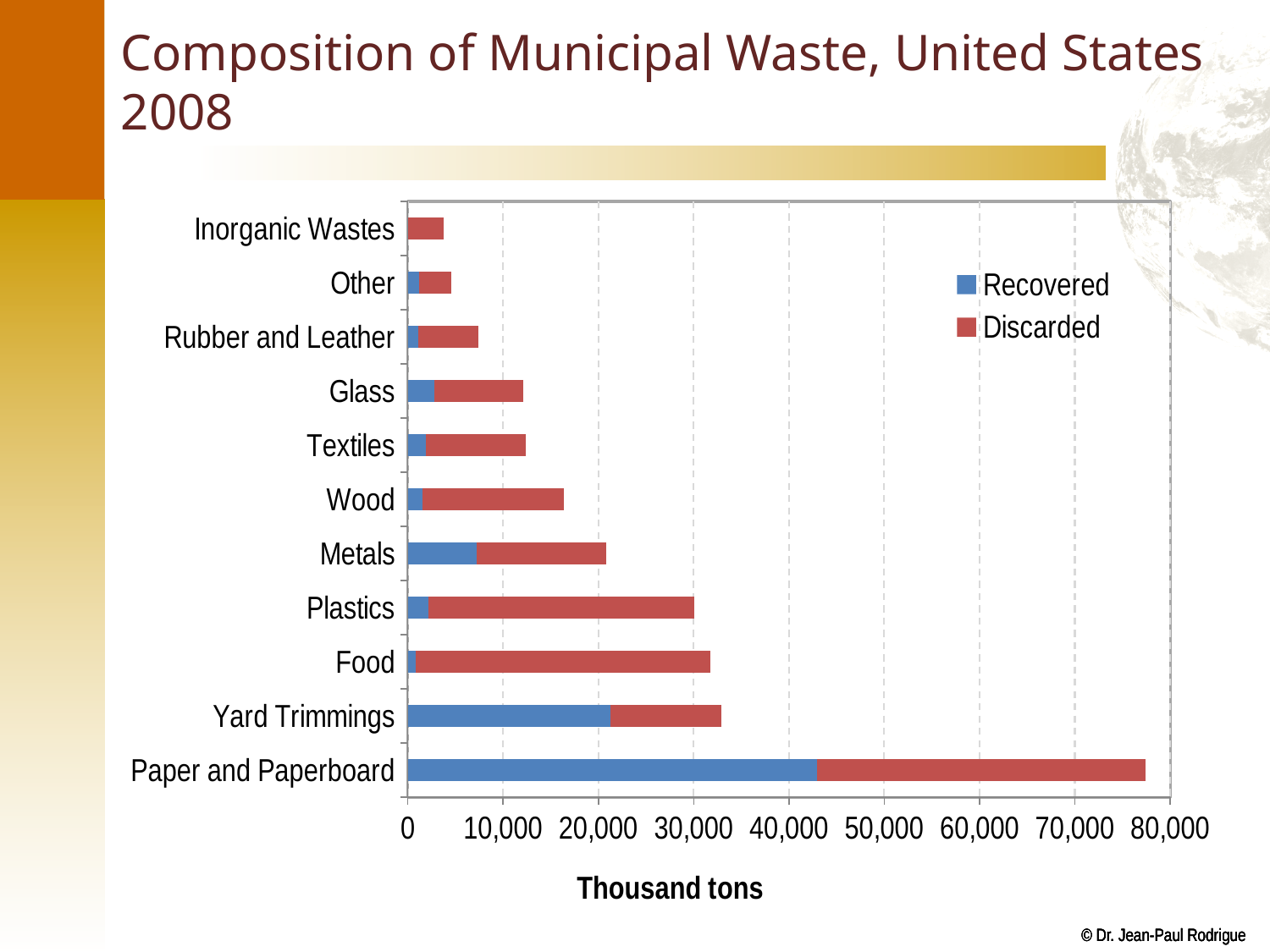
Is the total value for Yard Trimmings greater or less than 30,000? greater What kind of chart is shown on the slide? Stacked bar chart Which waste category has the largest total bar? Paper and Paperboard Which colour represents the Discarded series in the legend? Red Is the Recovered value for Metals greater or less than 10,000? less Is the total value for Wood greater or less than 20,000? less What is the label of the horizontal axis? Thousand tons How many series does the legend list? 2 Which has the larger Recovered value, Yard Trimmings or Food? Yard Trimmings How many waste categories are plotted on the chart? 11